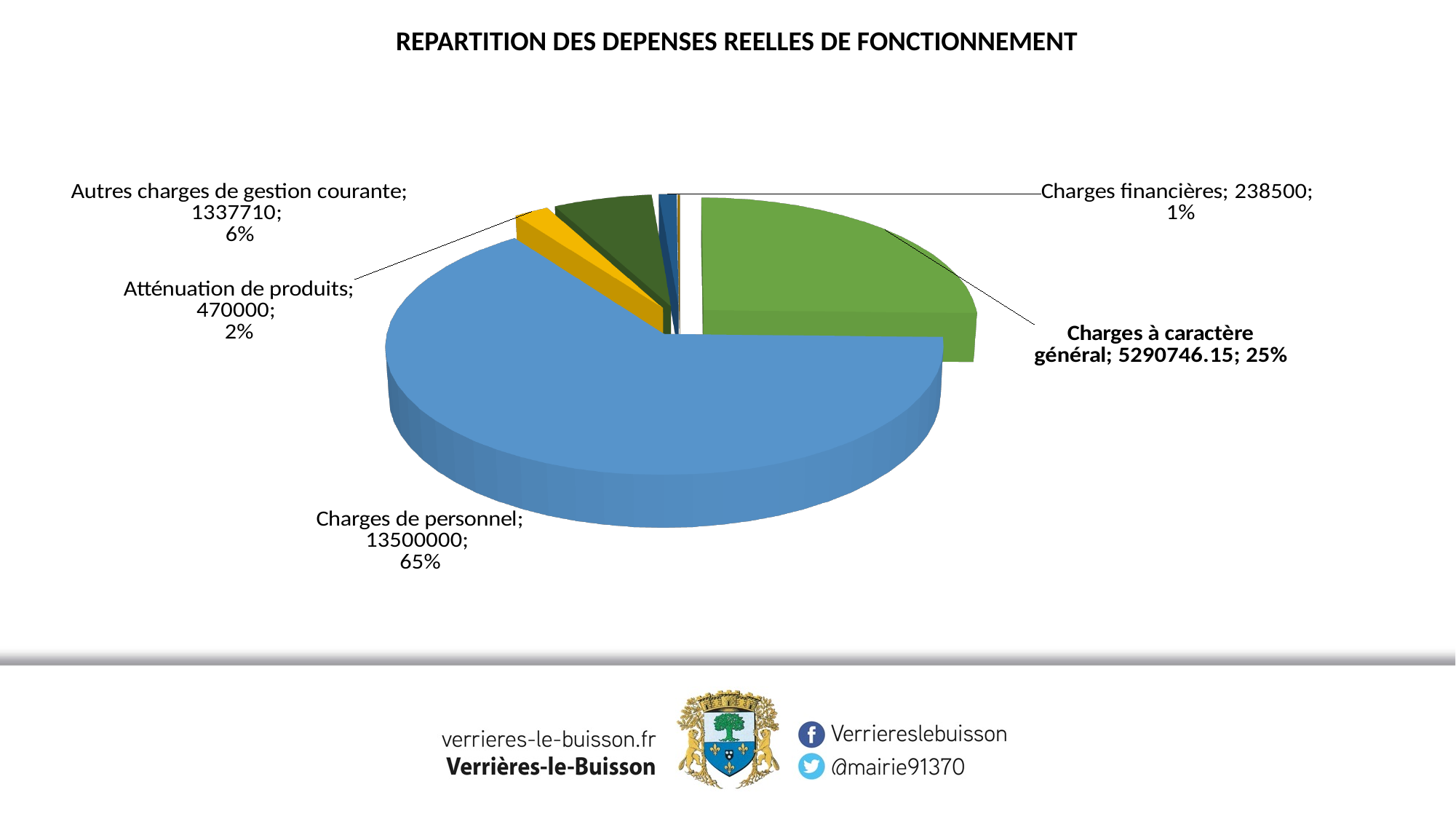
What is the title of the chart? REPARTITION DES DEPENSES REELLES DE FONCTIONNEMENT What is the value for Autres charges de gestion courante? 1337710 Which category has the largest slice? Charges de personnel What is the value for Charges financières? 238500 How many slices does the pie chart have? 6 What share of the pie does Atténuation de produits represent? 2% What is the value for Charges de personnel? 13500000 What kind of chart is shown on the slide? Pie chart What share of the pie does Charges de personnel represent? 65% What is the difference between the values for Atténuation de produits and Charges financières? 231500 What is the value for Charges à caractère général? 5290746.15